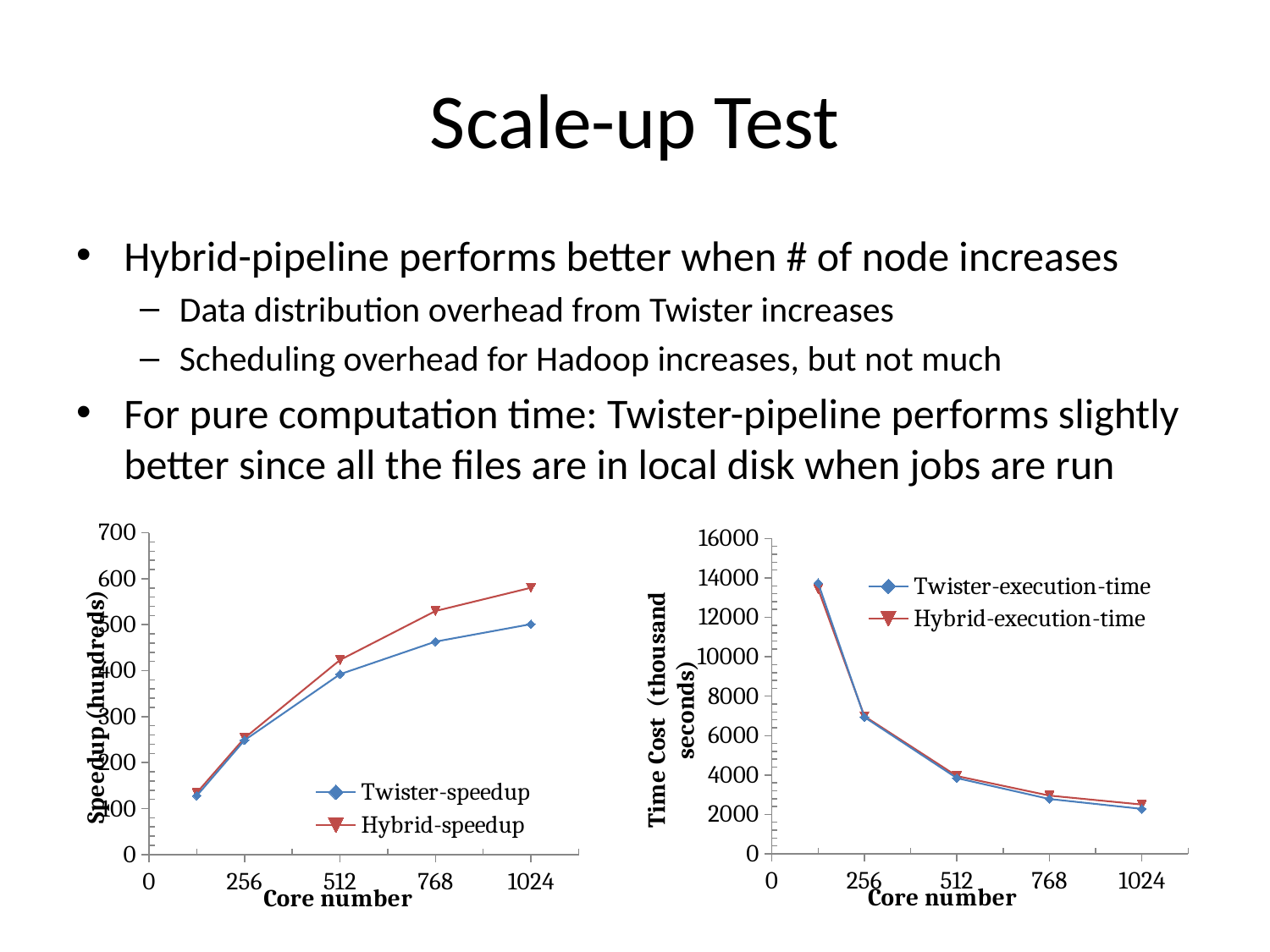
In the left chart, how many data points does each series have? 5 In the right chart, is the Twister-execution-time value at 256 cores greater or less than 8000? less How many series does the legend of the left chart list? 2 In the left chart, is the Twister-speedup value at 768 cores greater or less than 500? less In the left chart, which series has the higher value at 1024 cores, Twister-speedup or Hybrid-speedup? Hybrid-speedup In the left chart, do the speedup values rise or fall as the core number increases? rise What kind of chart is the left chart (Speedup vs Core number)? line chart In the right chart, do the time cost values rise or fall as the core number increases? fall What is the y-axis title of the left chart? Speedup (hundreds) In the right chart, is the Hybrid-execution-time value at 512 cores greater or less than 6000? less What kind of chart is the right chart (Time Cost vs Core number)? line chart